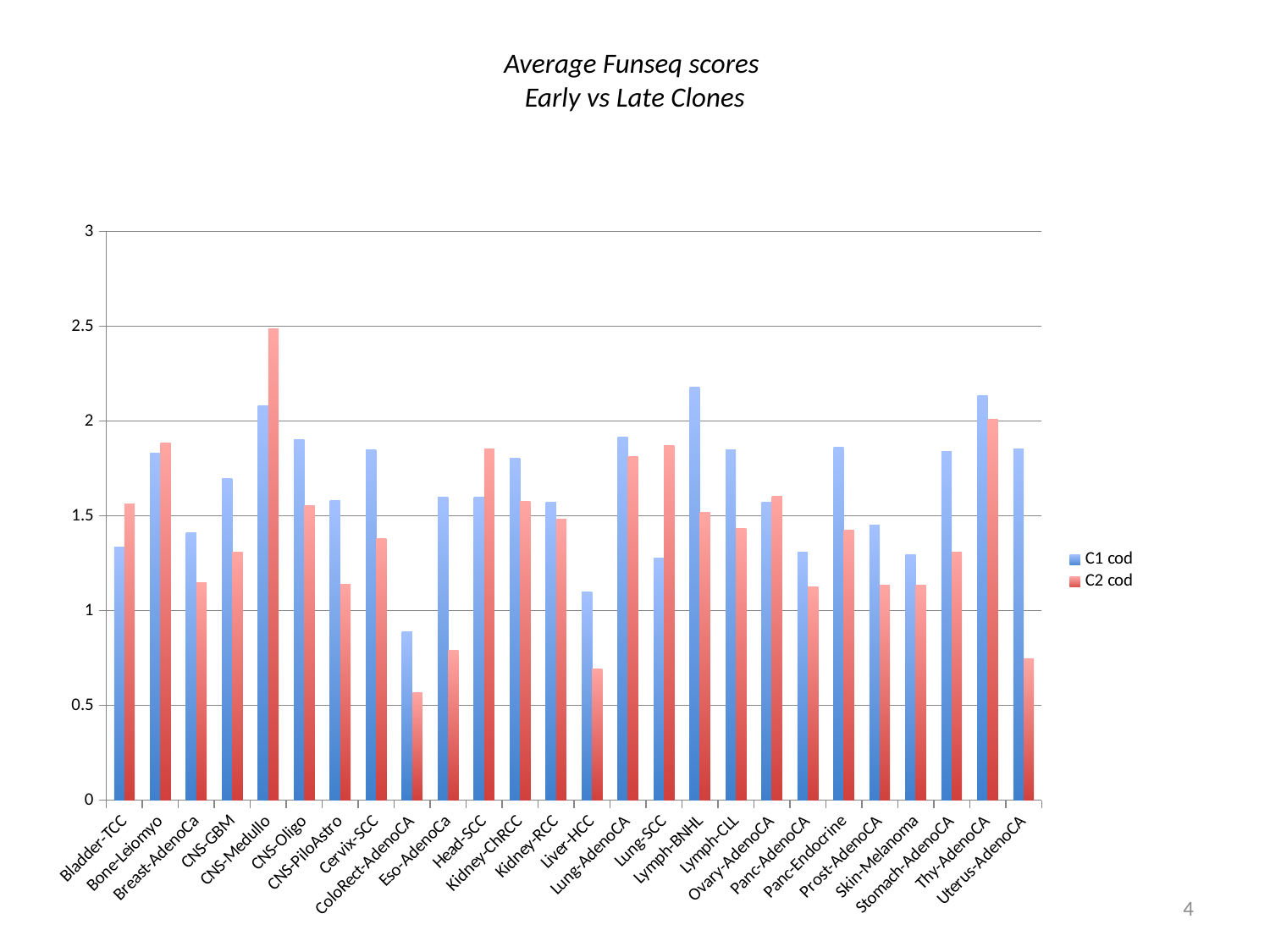
Is the C1 cod value for Liver-HCC greater or less than 1.5? less Is the C2 cod value for CNS-Medullo greater or less than 2? greater Which category has the lowest C2 cod value? ColoRect-AdenoCA How many series does the legend list? 2 What is the title of the chart? Average Funseq scores Early vs Late Clones Is the C2 cod value for Uterus-AdenoCA greater or less than 1? less For Lung-SCC, which series has the larger value, C1 cod or C2 cod? C2 cod Which category has the highest C2 cod value? CNS-Medullo How many cancer-type categories are shown on the x axis? 26 What type of chart is shown on the slide? bar chart Which category has the lowest C1 cod value? ColoRect-AdenoCA